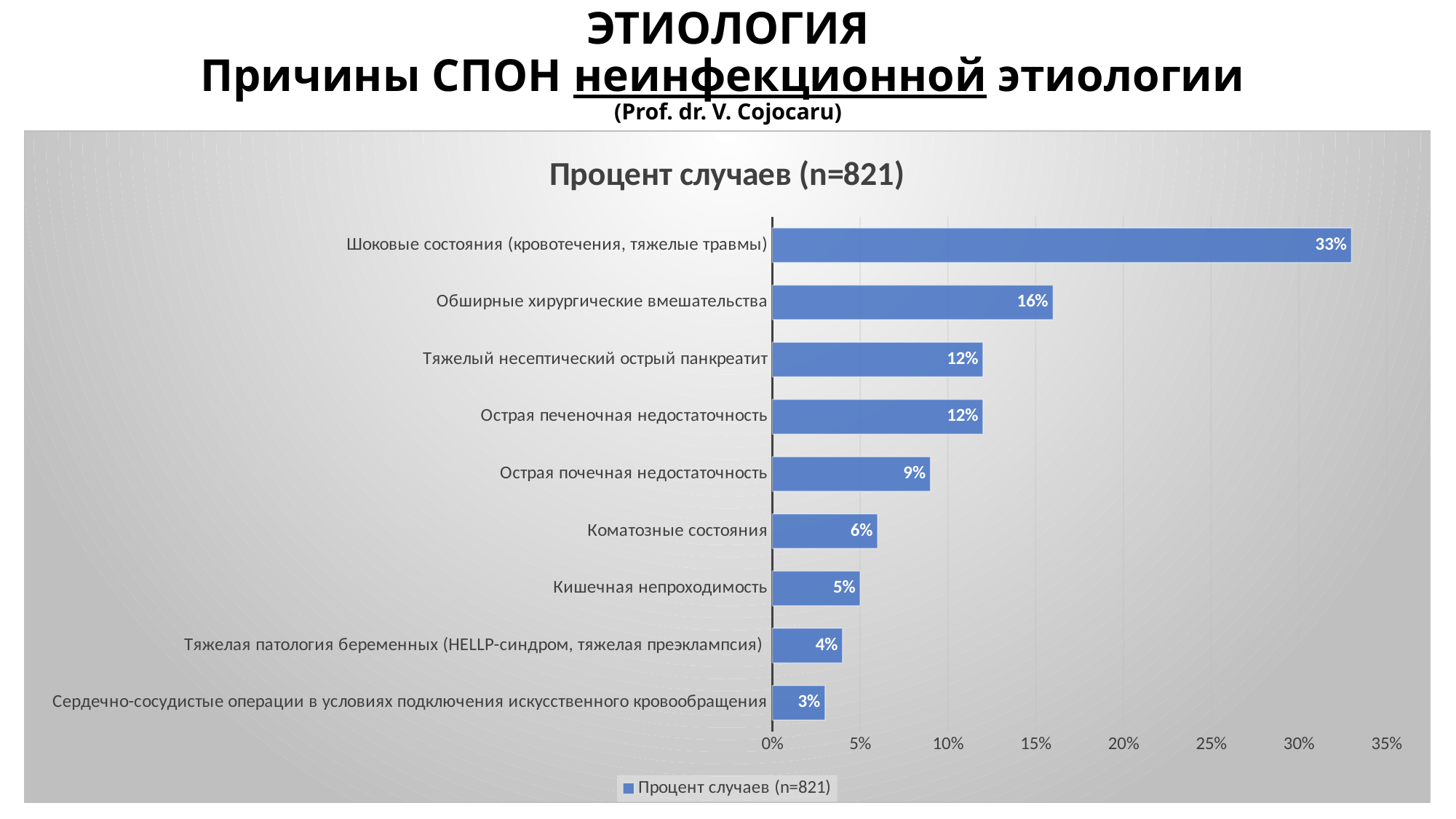
Which category has the lowest value? Сердечно-сосудистые операции в условиях подключения искусственного кровообращения What is the value for Обширные хирургические вмешательства? 16% What is the difference between the values for Шоковые состояния (кровотечения, тяжелые травмы) and Обширные хирургические вмешательства? 17% What is the title of the chart? Процент случаев (n=821) What is the value for Сердечно-сосудистые операции в условиях подключения искусственного кровообращения? 3% What is the value for Шоковые состояния (кровотечения, тяжелые травмы)? 33% How many categories are shown in the chart? 9 Which is larger: the value for Коматозные состояния or the value for Кишечная непроходимость? Коматозные состояния Which category has the highest value? Шоковые состояния (кровотечения, тяжелые травмы) Is the value for Тяжелый несептический острый панкреатит greater or less than 10%? greater What is the value for Острая почечная недостаточность? 9% What kind of chart is shown on the slide? bar chart